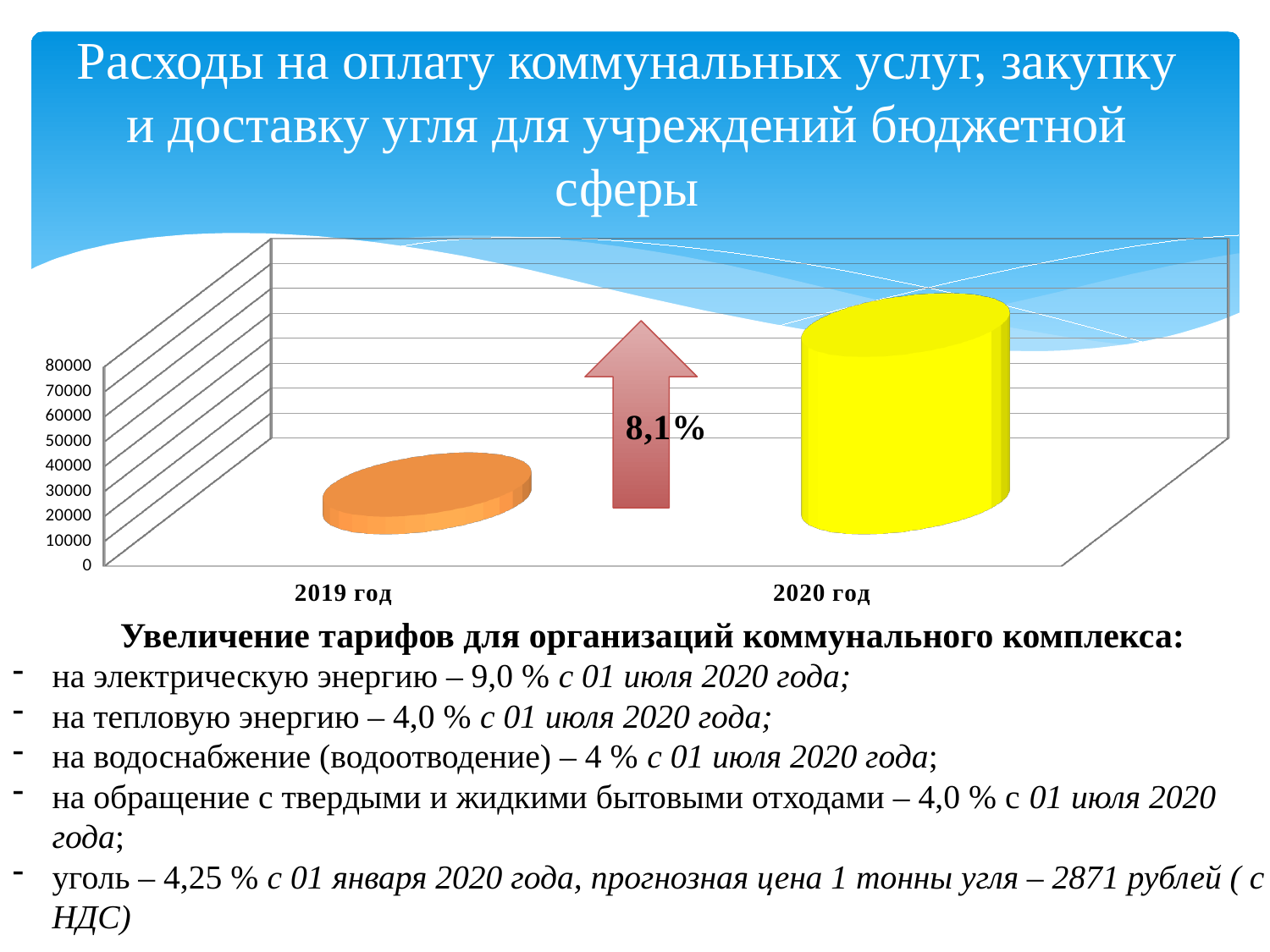
Which category has the lowest value in the chart? 2019 год Which category has the highest value in the chart? 2020 год Do the values rise or fall from 2019 год to 2020 год? rise What percentage is written next to the arrow between the two bars? 8,1% What is the highest value shown on the vertical axis of the chart? 80000 Is the value for 2020 год greater or less than 40000? greater Is the value for 2019 год greater or less than 20000? less Which is larger, the value for 2019 год or the value for 2020 год? 2020 год How many categories are shown on the x axis of the chart? 2 What kind of chart is shown on the slide? bar chart